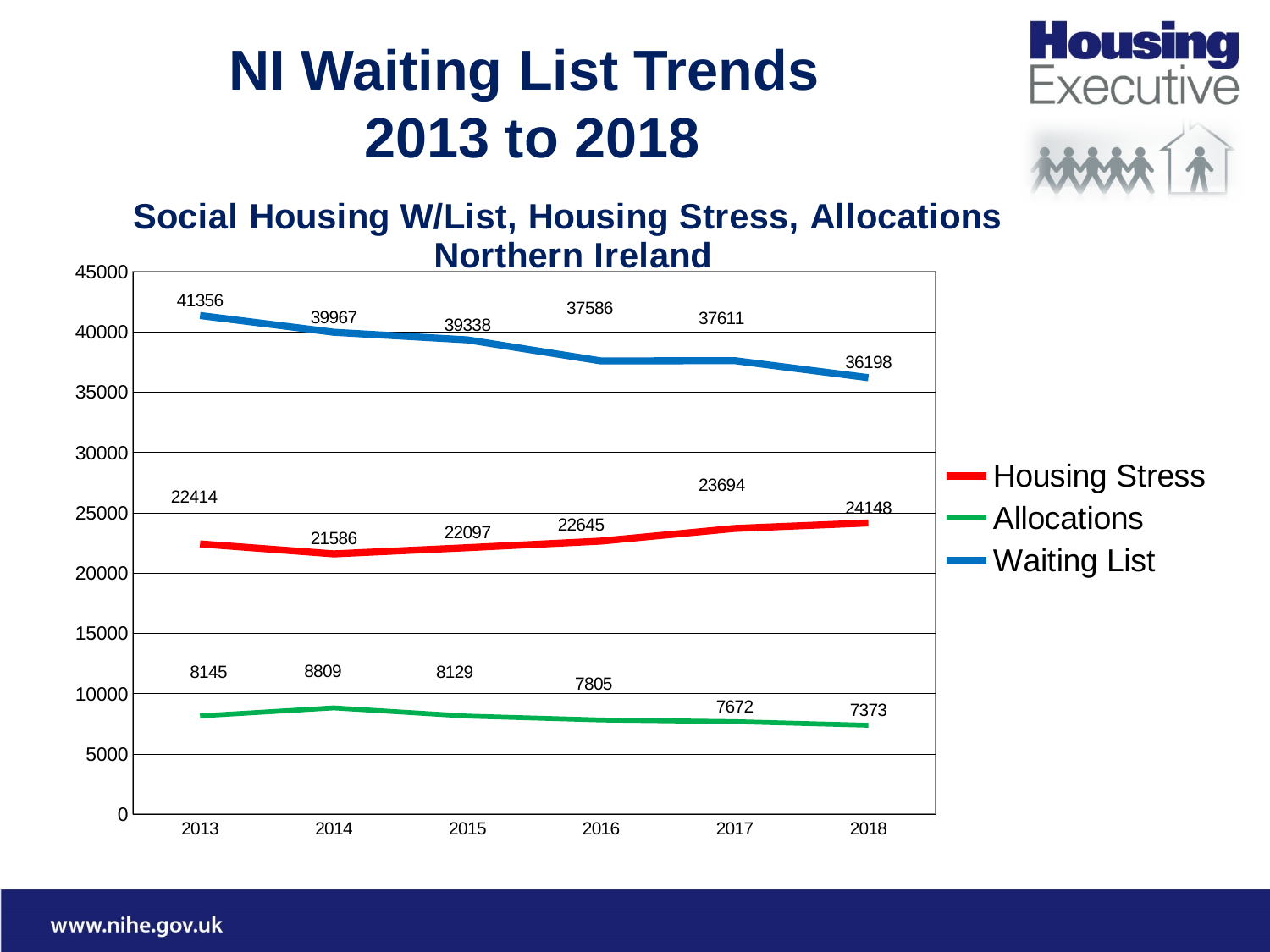
How many years are shown on the x axis? 6 What is the Allocations value for 2016? 7805 What is the Waiting List value for 2013? 41356 In which year is the Allocations series highest? 2014 What is the Housing Stress value for 2018? 24148 How many series does the legend list? 3 Which is larger, the Housing Stress value for 2017 or for 2016? 2017 What is the difference between the Waiting List values for 2013 and 2018? 5158 In which year is the Waiting List series lowest? 2018 What kind of chart is shown? line chart Is the Waiting List value for 2016 greater or less than 40000? less Does the Waiting List series rise or fall from 2013 to 2018? fall